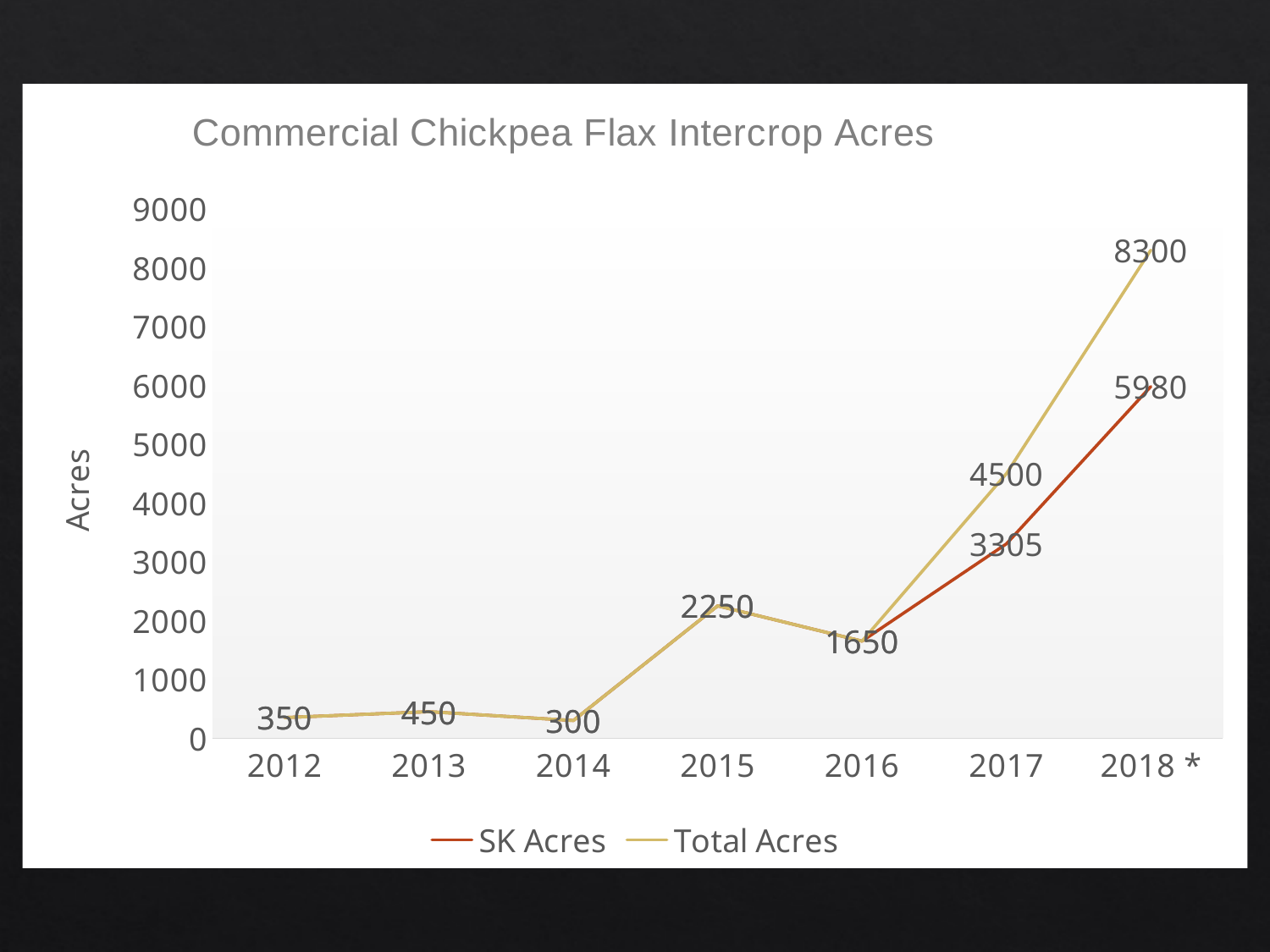
What is the Total Acres value for 2017? 4500 What is the difference between Total Acres and SK Acres in 2018 *? 2320 What kind of chart is shown on the slide? line chart What is the SK Acres value for 2018 *? 5980 What is the title of the chart? Commercial Chickpea Flax Intercrop Acres What value is labelled for 2015? 2250 How many series does the legend list? 2 What is the SK Acres value for 2017? 3305 Which year has the lowest labelled value? 2014 How many years are shown on the x axis? 7 Which is larger in 2017, Total Acres or SK Acres? Total Acres What is the Total Acres value for 2018 *? 8300